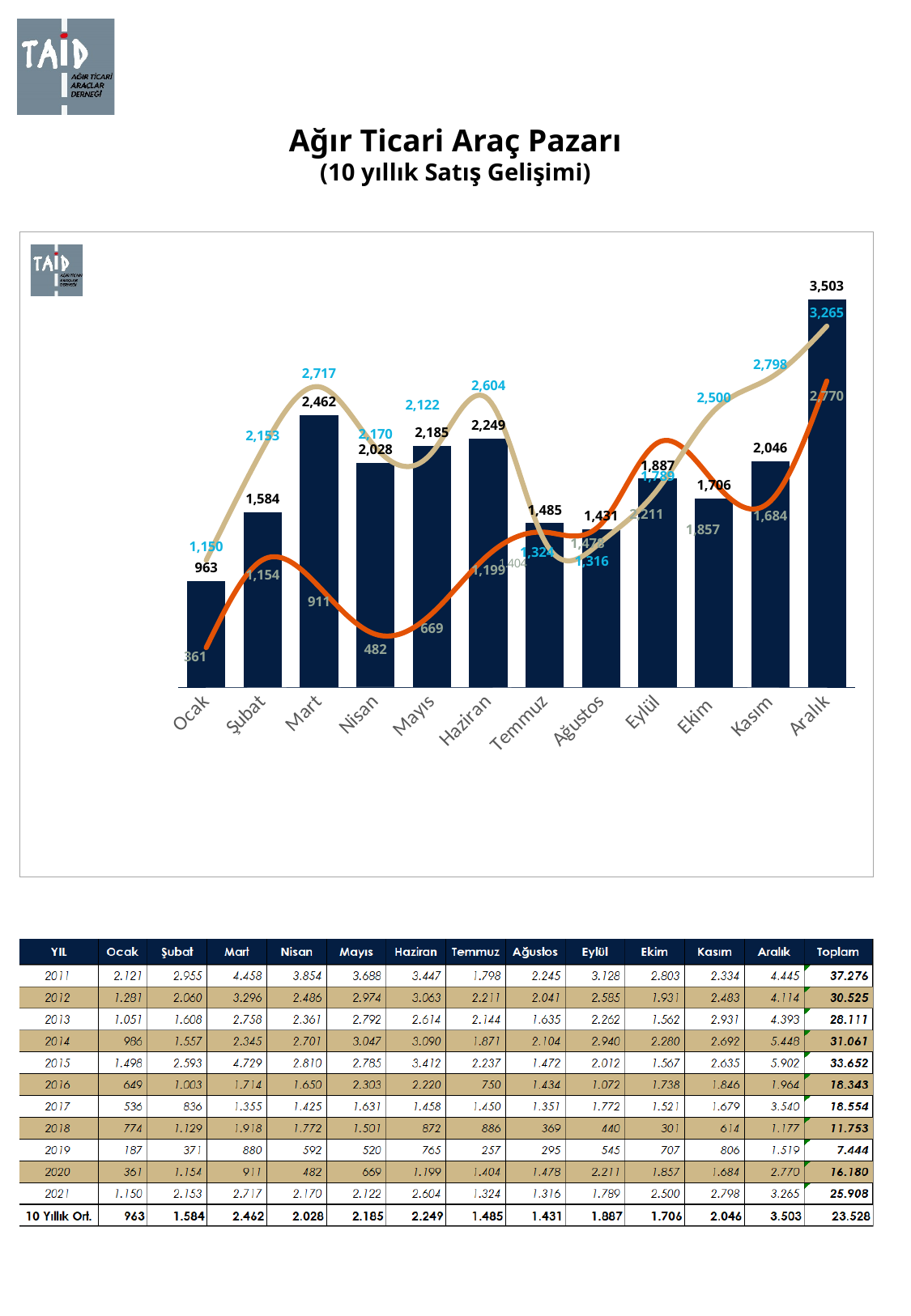
What is the difference between the bar values for Mart and Nisan? 434 Which month has the lowest bar? Ocak What is the title of the slide? Ağır Ticari Araç Pazarı (10 yıllık Satış Gelişimi) Which bar is taller, Mayıs or Haziran? Haziran What is the value of the bar for Aralık? 3,503 What kind of chart is shown on the slide? Combined bar and line chart Which month has the highest bar? Aralık How many months are shown on the x axis of the chart? 12 What is the value of the bar for Ocak? 963 What is the value labelled on the beige line for Mart? 2,717 What is the value labelled on the orange line for Nisan? 482